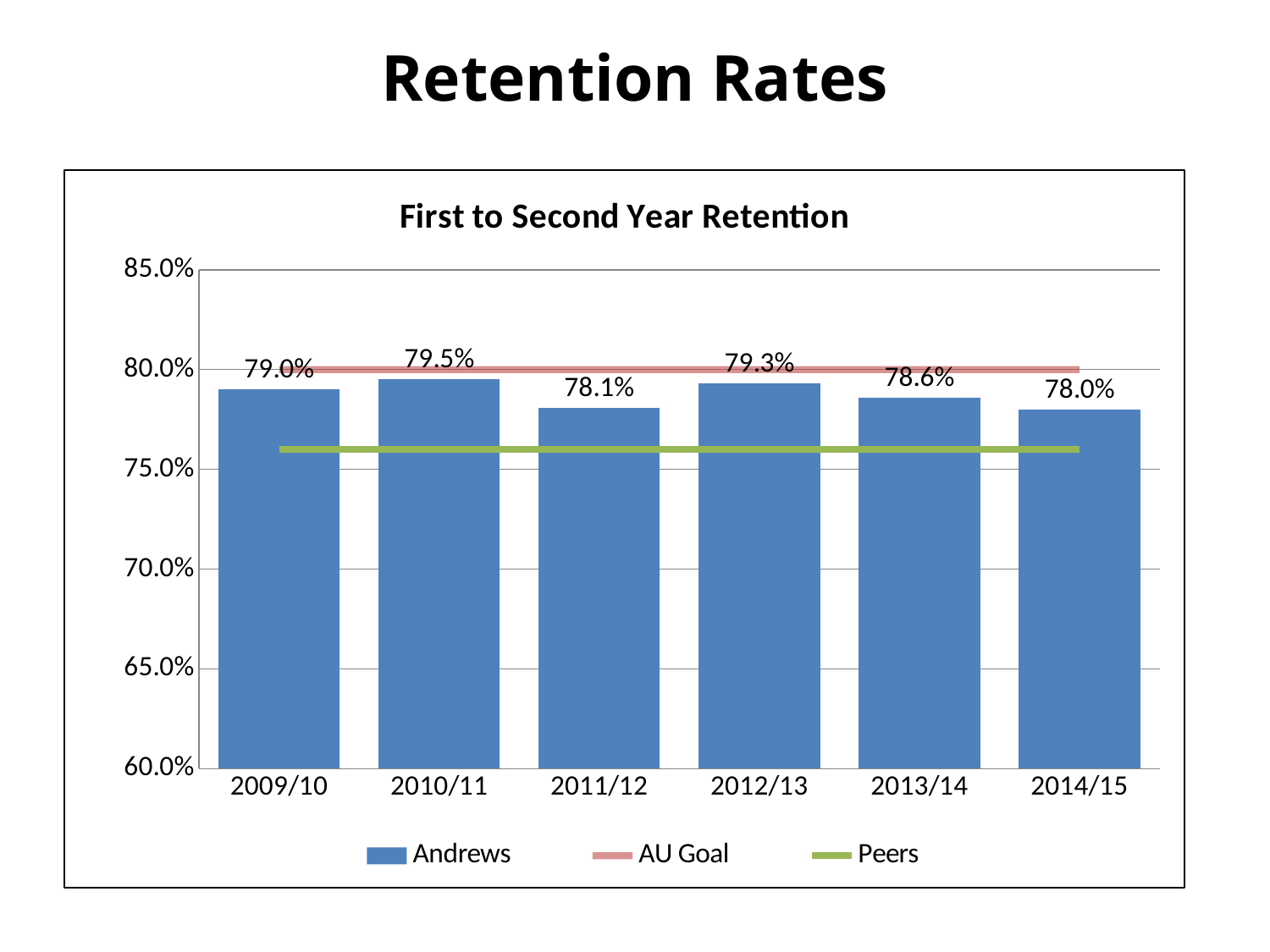
What is the Andrews retention rate for 2012/13? 79.3% What is the difference between the Andrews retention rate in 2010/11 and in 2011/12? 1.4% Which year has the highest Andrews retention rate? 2010/11 Which is larger, the Andrews retention rate in 2009/10 or in 2013/14? 2009/10 How many series does the legend list? 3 How many years are shown on the x axis? 6 What is the Andrews retention rate for 2014/15? 78.0% What is the title of the chart? First to Second Year Retention What is the Andrews retention rate for 2010/11? 79.5% Is the Peers line greater or less than 75.0%? greater Which year has the lowest Andrews retention rate? 2014/15